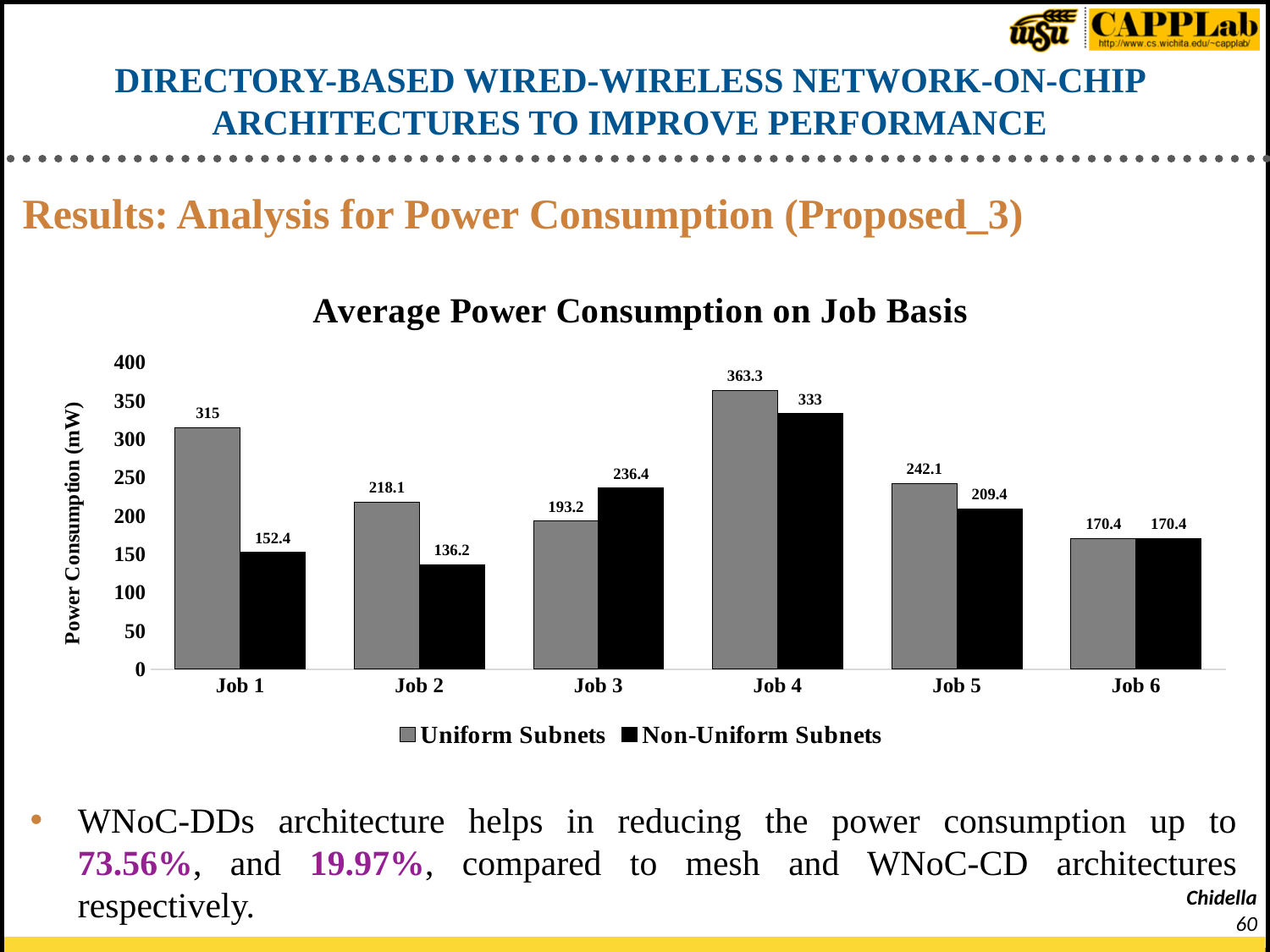
For Job 3, which series has the larger value, Uniform Subnets or Non-Uniform Subnets? Non-Uniform Subnets How many jobs are shown on the x axis? 6 What is the Non-Uniform Subnets value for Job 5? 209.4 What is the Uniform Subnets power consumption for Job 1? 315 What is the title of the chart? Average Power Consumption on Job Basis Which job has the lowest Non-Uniform Subnets power consumption? Job 2 Is the Uniform Subnets value for Job 2 greater or less than 200? greater What is the Non-Uniform Subnets power consumption for Job 3? 236.4 Which job has the highest Uniform Subnets power consumption? Job 4 What kind of chart is shown on the slide? Bar chart How many series does the legend list? 2 What is the difference between the Uniform Subnets and Non-Uniform Subnets values for Job 1? 162.6